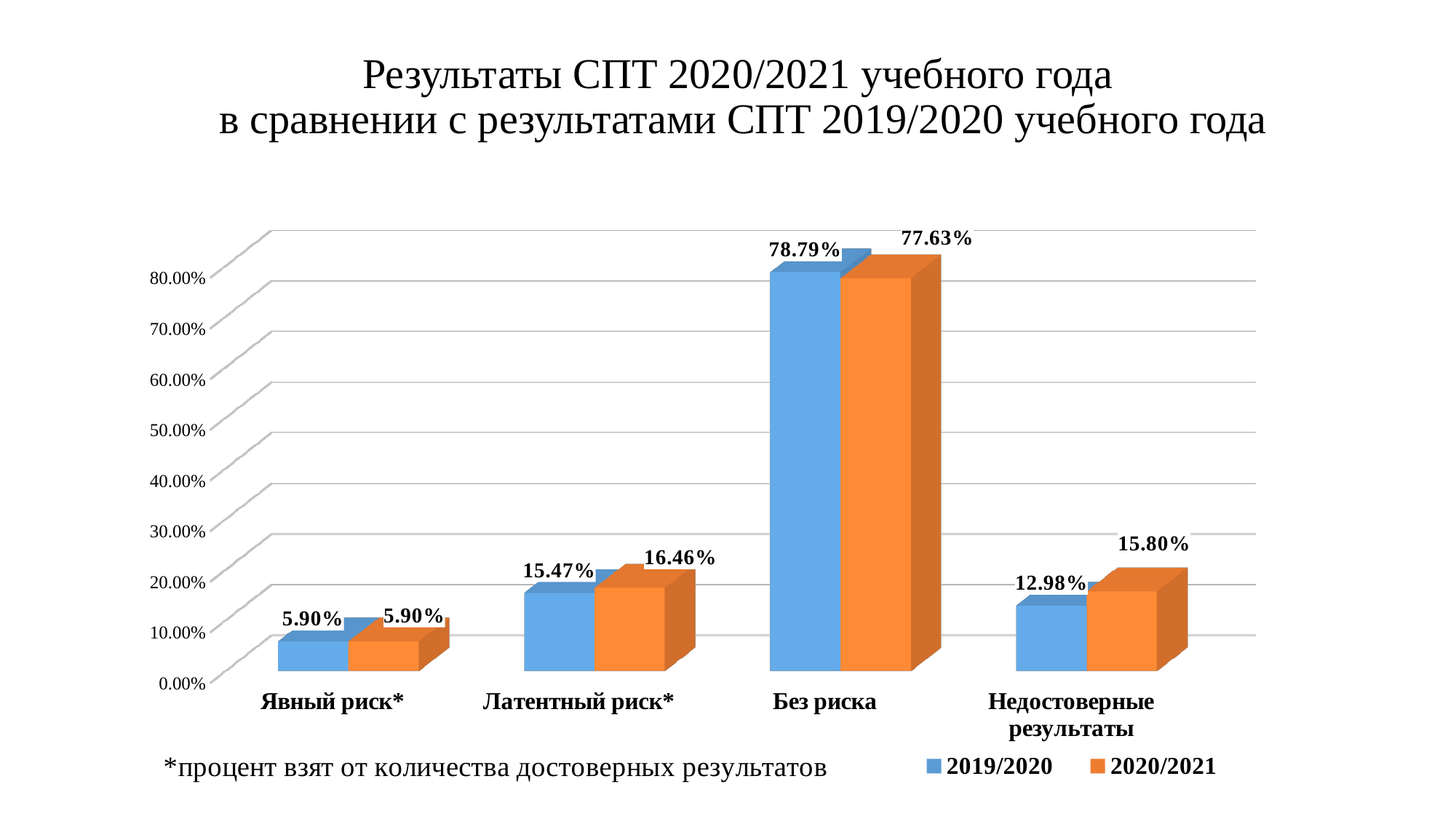
Which category has the lowest value for the 2019/2020 series? Явный риск* Which colour represents the 2020/2021 series? Orange What is the value for 2020/2021 in the "Латентный риск*" category? 16.46% What is the value for 2019/2020 in the "Явный риск*" category? 5.90% Which category has the highest value for the 2020/2021 series? Без риска Which is larger for "Недостоверные результаты": the 2019/2020 value or the 2020/2021 value? 2020/2021 How many series does the legend list? 2 What is the value for 2020/2021 in the "Недостоверные результаты" category? 15.80% What is the value for 2019/2020 in the "Без риска" category? 78.79% What kind of chart is shown on the slide? Bar chart What is the difference between the 2019/2020 and 2020/2021 values for "Без риска"? 1.16% How many categories are shown on the x axis? 4